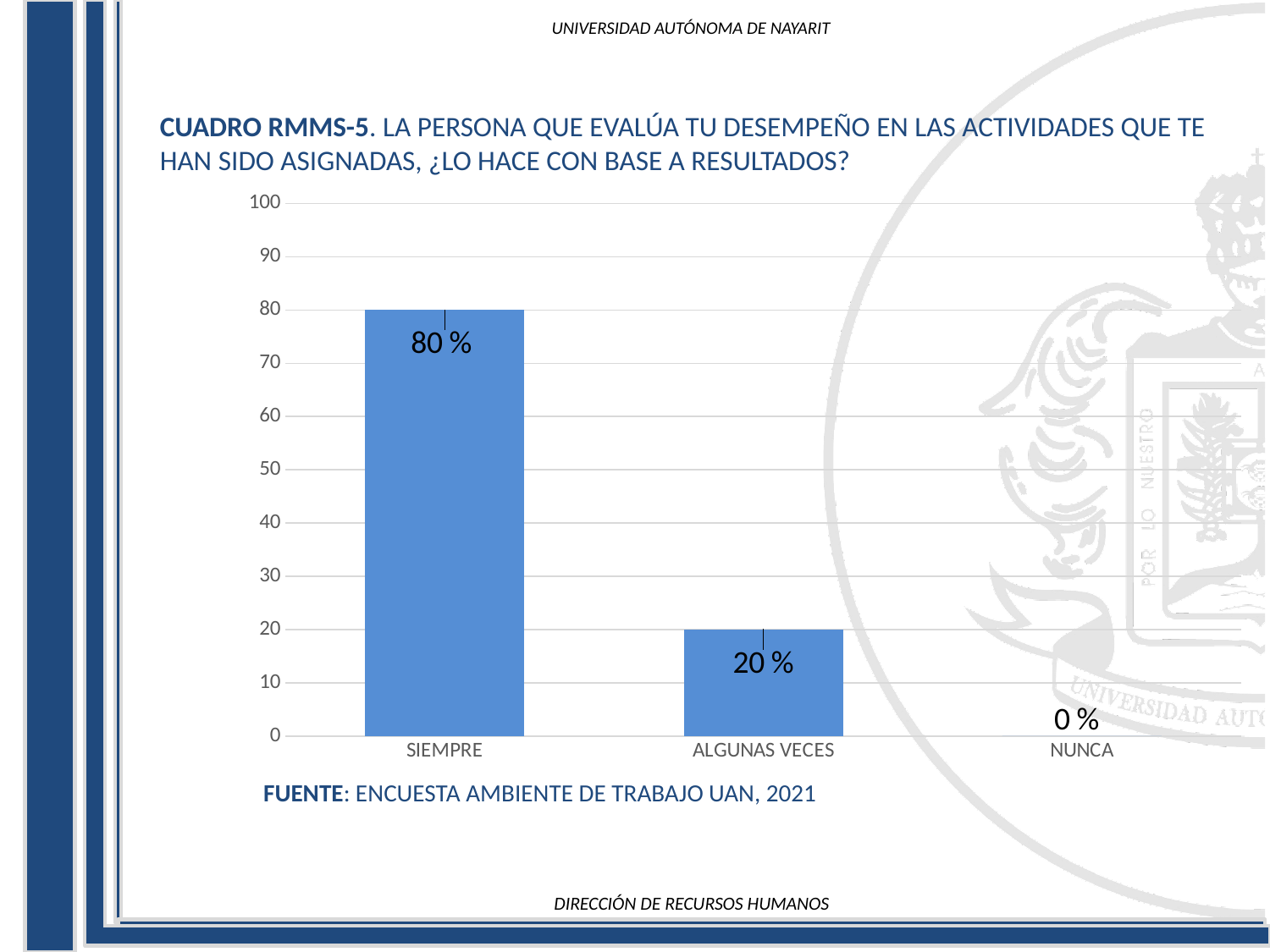
Do the values rise or fall from left to right along the x axis? fall What is the source cited below the chart? ENCUESTA AMBIENTE DE TRABAJO UAN, 2021 What kind of chart is shown on the slide? bar chart Which category has the lowest value? NUNCA Which category has the highest value? SIEMPRE Is the value for SIEMPRE greater or less than 50? greater Which is larger, the value for ALGUNAS VECES or the value for NUNCA? ALGUNAS VECES What is the value for NUNCA? 0 % What is the difference between the values for SIEMPRE and ALGUNAS VECES? 60 % What is the value for ALGUNAS VECES? 20 % What is the value for SIEMPRE? 80 % How many categories are shown on the x axis? 3